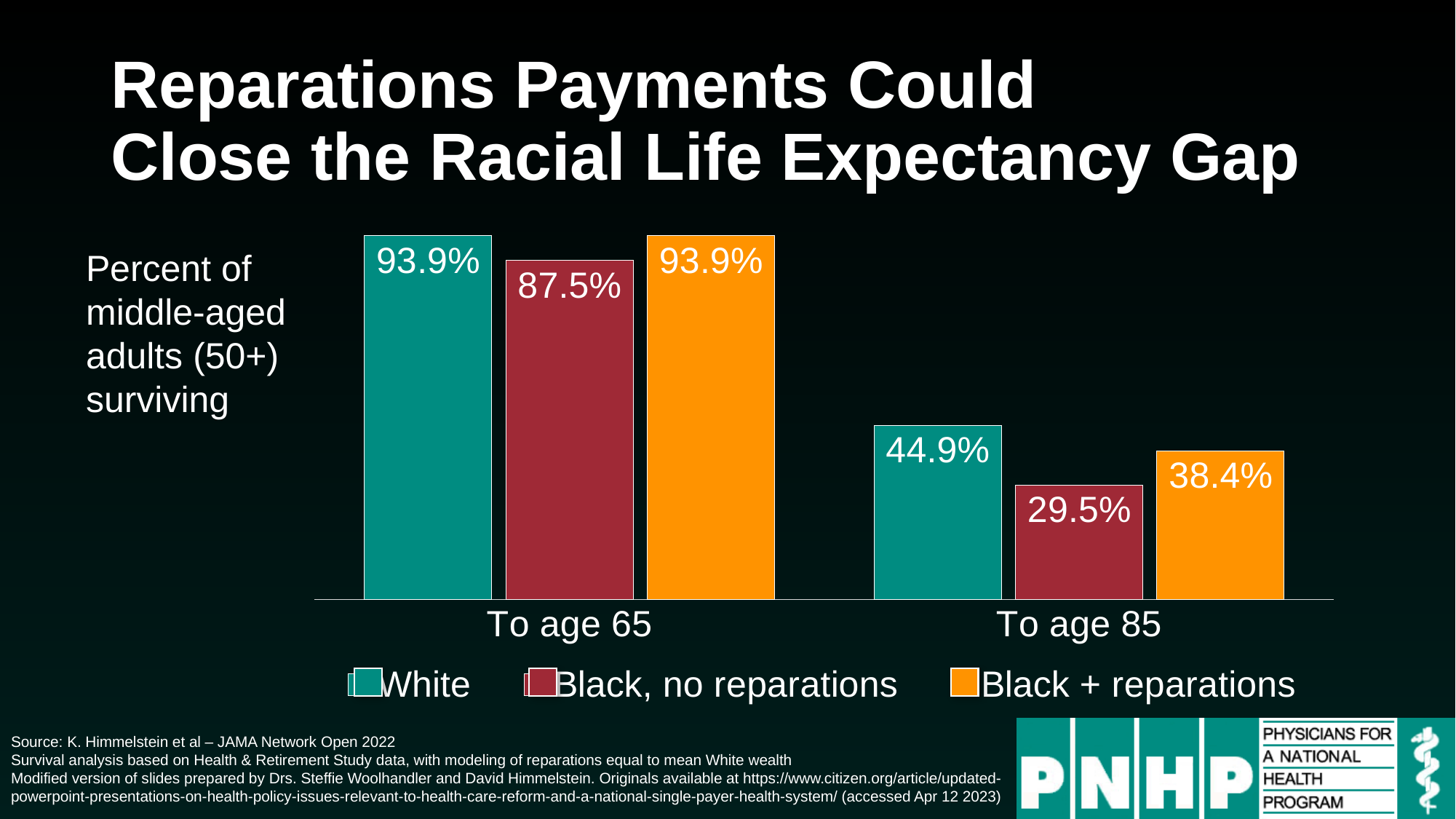
What is the value for Black, no reparations in the 'To age 65' group? 87.5% How many series does the legend list? 3 Which is larger for surviving to age 85: the White value or the Black + reparations value? White What percent of Black middle-aged adults with no reparations survive to age 85? 29.5% What is the value for Black + reparations in the 'To age 85' group? 38.4% Which series has the lowest value in the 'To age 85' group? Black, no reparations What percent of White middle-aged adults survive to age 65? 93.9% What kind of chart is shown on the slide? Bar chart What is the difference between the White and Black, no reparations values for surviving to age 65? 6.4% What is the difference between the Black + reparations and Black, no reparations values for surviving to age 85? 8.9% How many categories are shown on the x axis? 2 What colour represents the 'Black + reparations' series? Orange